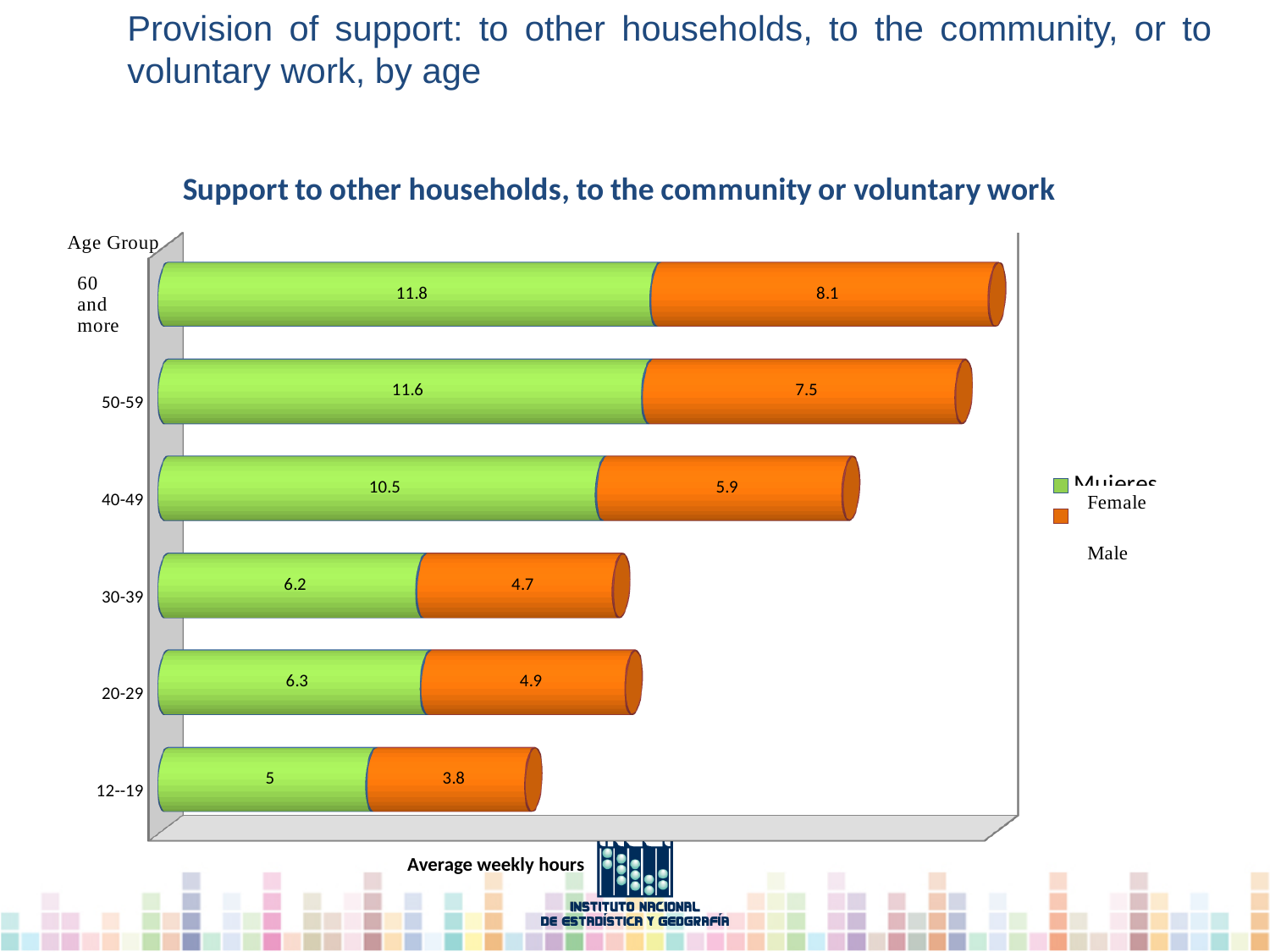
Which age group has the highest Female value? 60 and more What type of chart is shown? Stacked bar chart What is the difference between the Female and Male values for the 60 and more age group? 3.7 Which age group has the lowest Male value? 12--19 What is the Male value for the 50-59 age group? 7.5 What is the total of the stacked bar for the 12--19 age group? 8.8 What is the Female value for the 12--19 age group? 5 How many age groups are shown in the chart? 6 What is the total of the stacked bar for the 50-59 age group? 19.1 How many series does the legend list? 2 Which is larger, the Male value for 30-39 or the Male value for 20-29? 20-29 What is the Female value for the 40-49 age group? 10.5